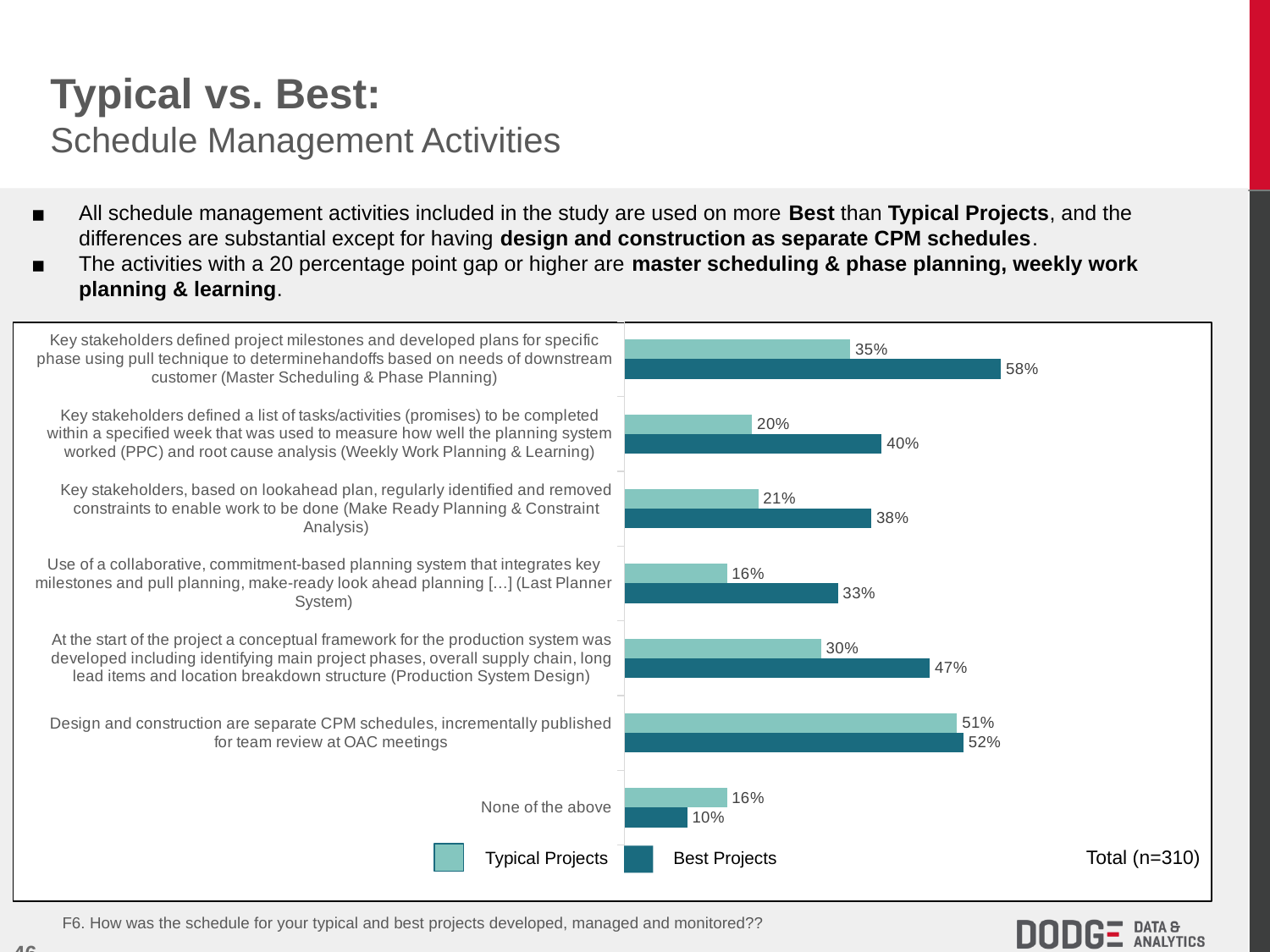
For None of the above, which is larger: the Typical Projects value or the Best Projects value? Typical Projects How many series does the legend list? 2 What is the Typical Projects value for Weekly Work Planning & Learning? 20% What is the Best Projects value for Last Planner System? 33% What is the difference between the Best Projects and Typical Projects values for Production System Design? 17 percentage points Which category has the lowest Best Projects value? None of the above Which category has the highest Best Projects value? Master Scheduling & Phase Planning What is the Typical Projects value for None of the above? 16% What is the Best Projects value for Master Scheduling & Phase Planning? 58% What sample size is noted on the chart? Total (n=310) How many categories are shown on the chart? 7 What kind of chart is shown on the slide? Bar chart